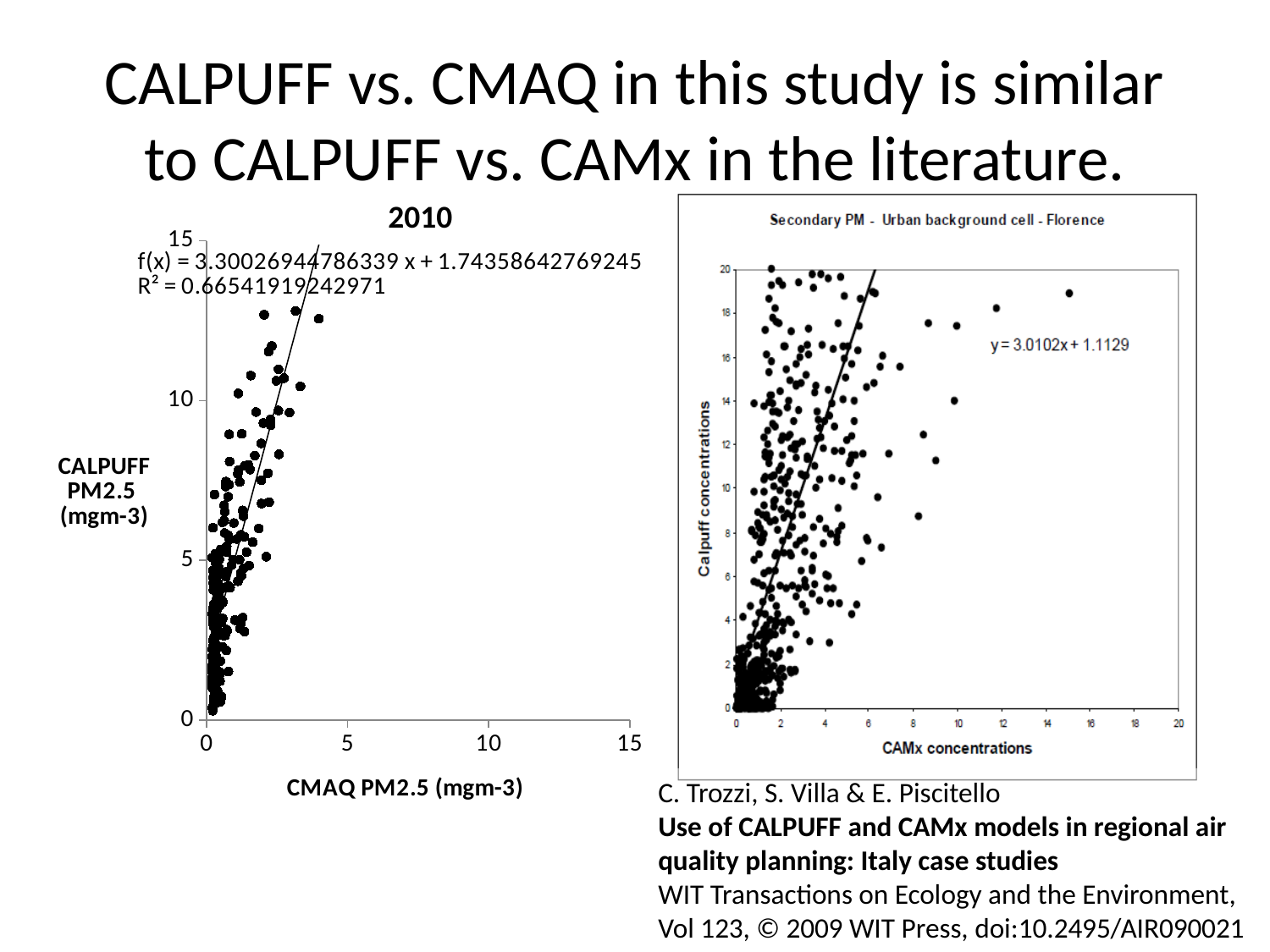
In the left chart titled "2010", what is the trendline equation printed on the chart? f(x) = 3.30026944786339 x + 1.74358642769245 What kind of chart is the right chart titled "Secondary PM - Urban background cell - Florence"? scatter chart In the right chart titled "Secondary PM - Urban background cell - Florence", what is the label of the x axis? CAMx concentrations In the left chart titled "2010", what is the R² value printed for the trendline? 0.66541919242971 In the left chart titled "2010", what is the maximum value shown on the y axis? 15 In the right chart titled "Secondary PM - Urban background cell - Florence", do the Calpuff concentrations generally rise or fall as CAMx concentrations increase along the x axis? rise In the left chart titled "2010", what is the label of the y axis? CALPUFF PM2.5 (mgm-3) In the left chart titled "2010", do the CALPUFF PM2.5 values generally rise or fall as CMAQ PM2.5 increases along the x axis? rise What kind of chart is the left chart titled "2010"? scatter chart Which chart has the larger trendline slope: the left chart titled "2010" or the right chart titled "Secondary PM - Urban background cell - Florence"? the left chart titled "2010" In the right chart titled "Secondary PM - Urban background cell - Florence", what is the regression equation printed on the chart? y = 3.0102x + 1.1129 In the left chart titled "2010", what is the label of the x axis? CMAQ PM2.5 (mgm-3)